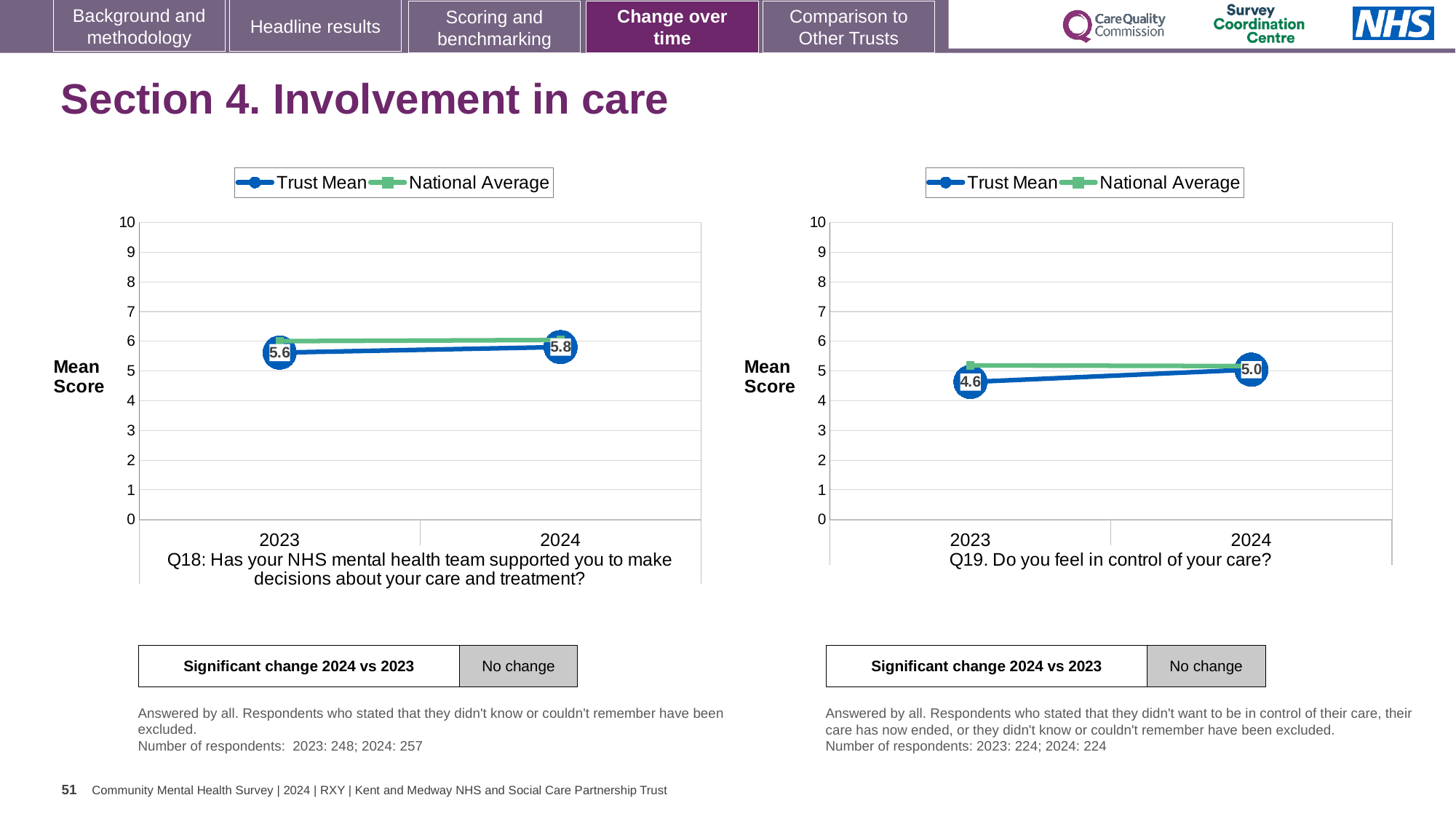
In the Q19 chart on the right, what is the Trust Mean score for 2023? 4.6 What is the maximum value shown on the y axis of the Q18 chart on the left? 10 In the Q18 chart on the left, which series has the higher value in 2023, Trust Mean or National Average? National Average In the Q19 chart on the right, by how much did the Trust Mean change from 2023 to 2024? 0.4 In the Q18 chart on the left, does the Trust Mean rise or fall from 2023 to 2024? rise How many series does the legend of the Q18 chart on the left list? 2 In the Q18 chart on the left, what is the Trust Mean score for 2023? 5.6 What kind of chart is the Q19 chart on the right? line chart How many years are plotted on the x axis of the Q19 chart on the right? 2 In the Q19 chart on the right, what is the Trust Mean score for 2024? 5.0 In the Q19 chart on the right, is the National Average value for 2023 greater or less than 4? greater In the Q18 chart on the left, what is the Trust Mean score for 2024? 5.8